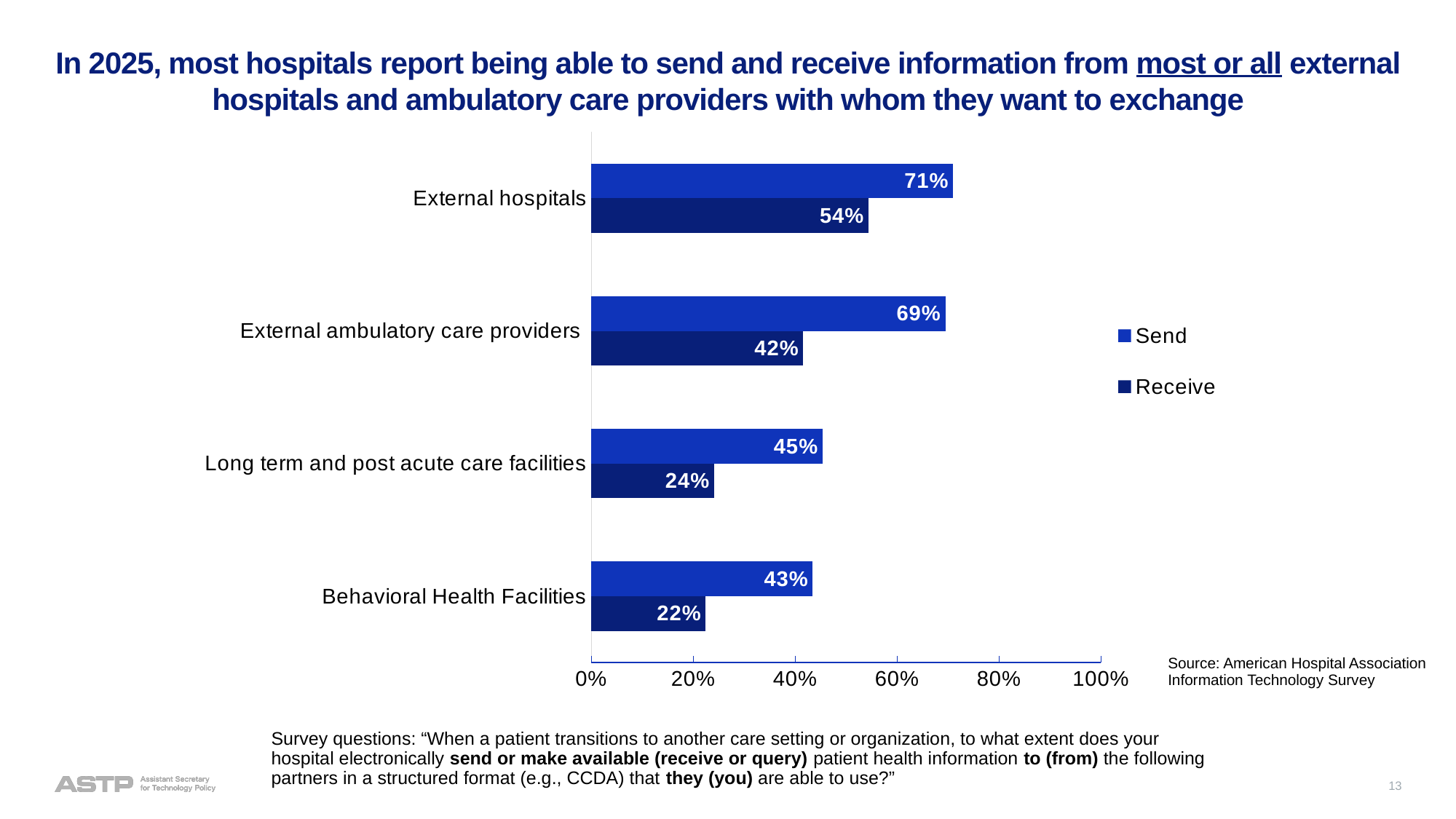
What kind of chart is shown on the slide? Bar chart Which is larger: the Receive value for External hospitals or the Send value for Long term and post acute care facilities? Receive value for External hospitals How many series does the legend list? 2 What percentage of hospitals report being able to send information to most or all external hospitals? 71% What is the Receive value for External ambulatory care providers? 42% How many categories are shown on the chart? 4 Which category has the highest Send value? External hospitals What is the difference between the Send and Receive values for External ambulatory care providers? 27 percentage points Is the Send value for Long term and post acute care facilities greater or less than 40%? greater What is the Receive value for Long term and post acute care facilities? 24% Which category has the lowest Receive value? Behavioral Health Facilities What is the Send value for Behavioral Health Facilities? 43%